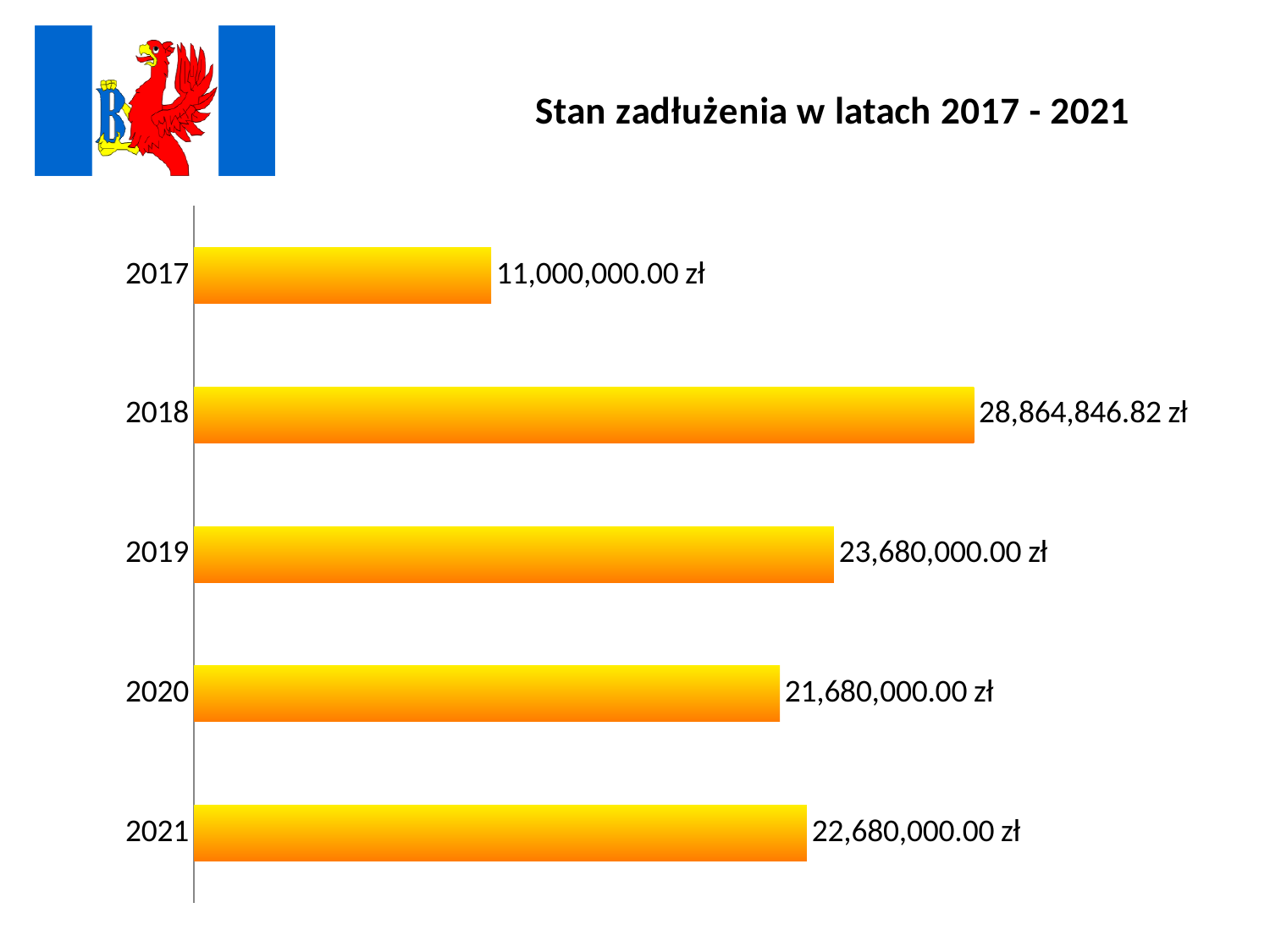
What is the value for 2020? 21,680,000.00 zł What is the value for 2017? 11,000,000.00 zł What is the difference between the values for 2021 and 2020? 1,000,000.00 zł Which year has the highest value? 2018 What is the value for 2018? 28,864,846.82 zł Which is larger, the value for 2019 or the value for 2021? 2019 What is the difference between the values for 2019 and 2020? 2,000,000.00 zł What kind of chart is this? Bar chart Which year has the lowest value? 2017 What is the title of the chart? Stan zadłużenia w latach 2017 - 2021 What is the value for 2021? 22,680,000.00 zł How many years are shown in the chart? 5